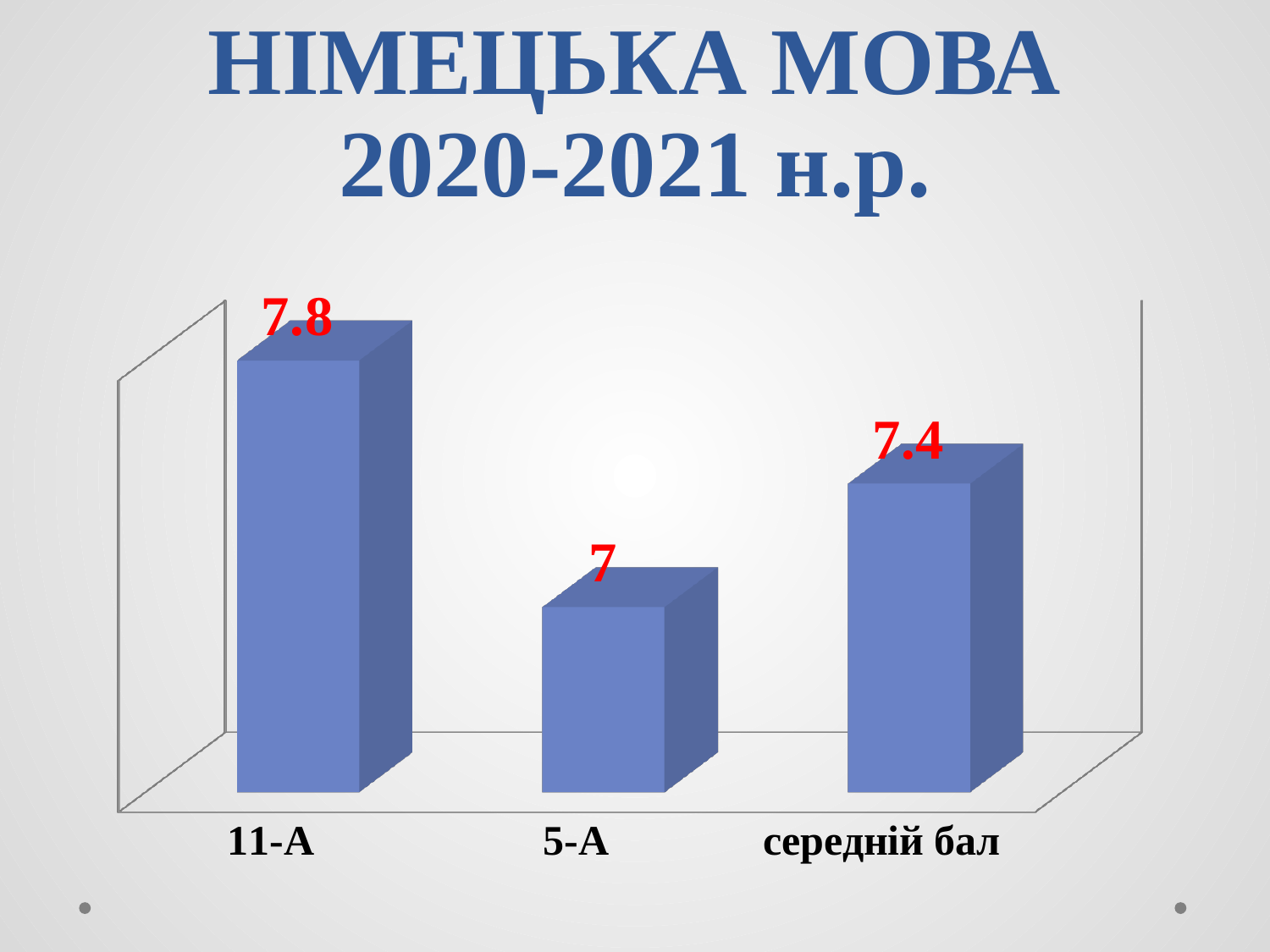
Which is larger, the value for 5-А or the value for середній бал? середній бал What kind of chart is shown on the slide? bar chart Which category has the highest value? 11-А Which category has the lowest value? 5-А What is the difference between the values for 11-А and середній бал? 0.4 What is the value for 5-А? 7 What is the value for середній бал? 7.4 What is the difference between the values for 11-А and 5-А? 0.8 What is the value for 11-А? 7.8 What colour are the bars in the chart? blue How many categories are shown in the chart? 3 What is the title of the slide? НІМЕЦЬКА МОВА 2020-2021 н.р.